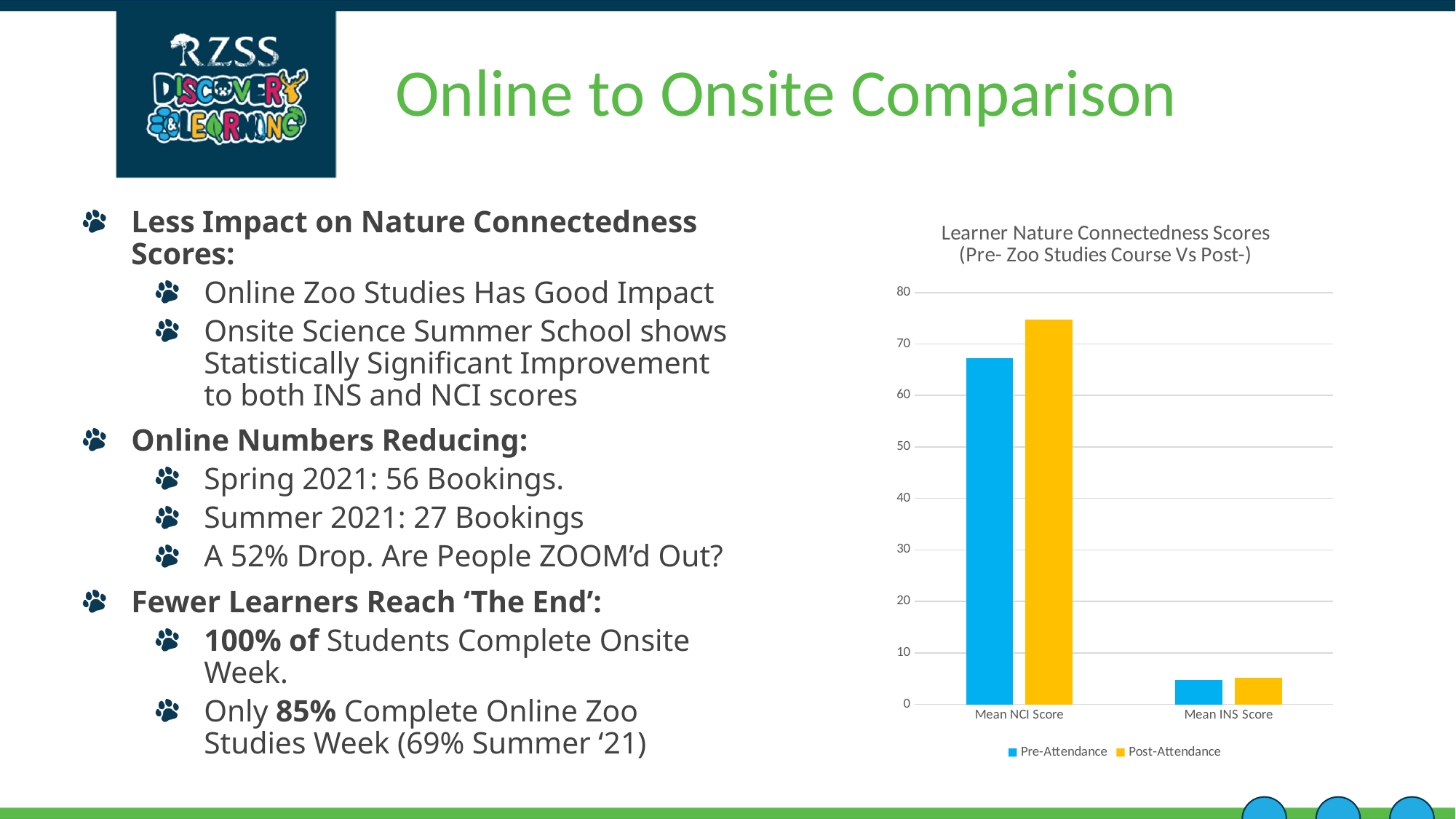
Which category has the lower scores in the chart, Mean NCI Score or Mean INS Score? Mean INS Score Which bar in the chart is the highest? Post-Attendance, Mean NCI Score Is the Post-Attendance value for Mean NCI Score greater or less than 70? greater Is the Pre-Attendance value for Mean INS Score greater or less than 10? less What is the title of the chart? Learner Nature Connectedness Scores (Pre- Zoo Studies Course Vs Post-) Which series is shown in yellow in the chart? Post-Attendance How many series does the chart legend list? 2 How many categories are shown on the x axis of the chart? 2 Is the Pre-Attendance value for Mean NCI Score greater or less than 60? greater For Mean NCI Score, which is larger: the Pre-Attendance or the Post-Attendance value? Post-Attendance What kind of chart is shown on the slide? bar chart